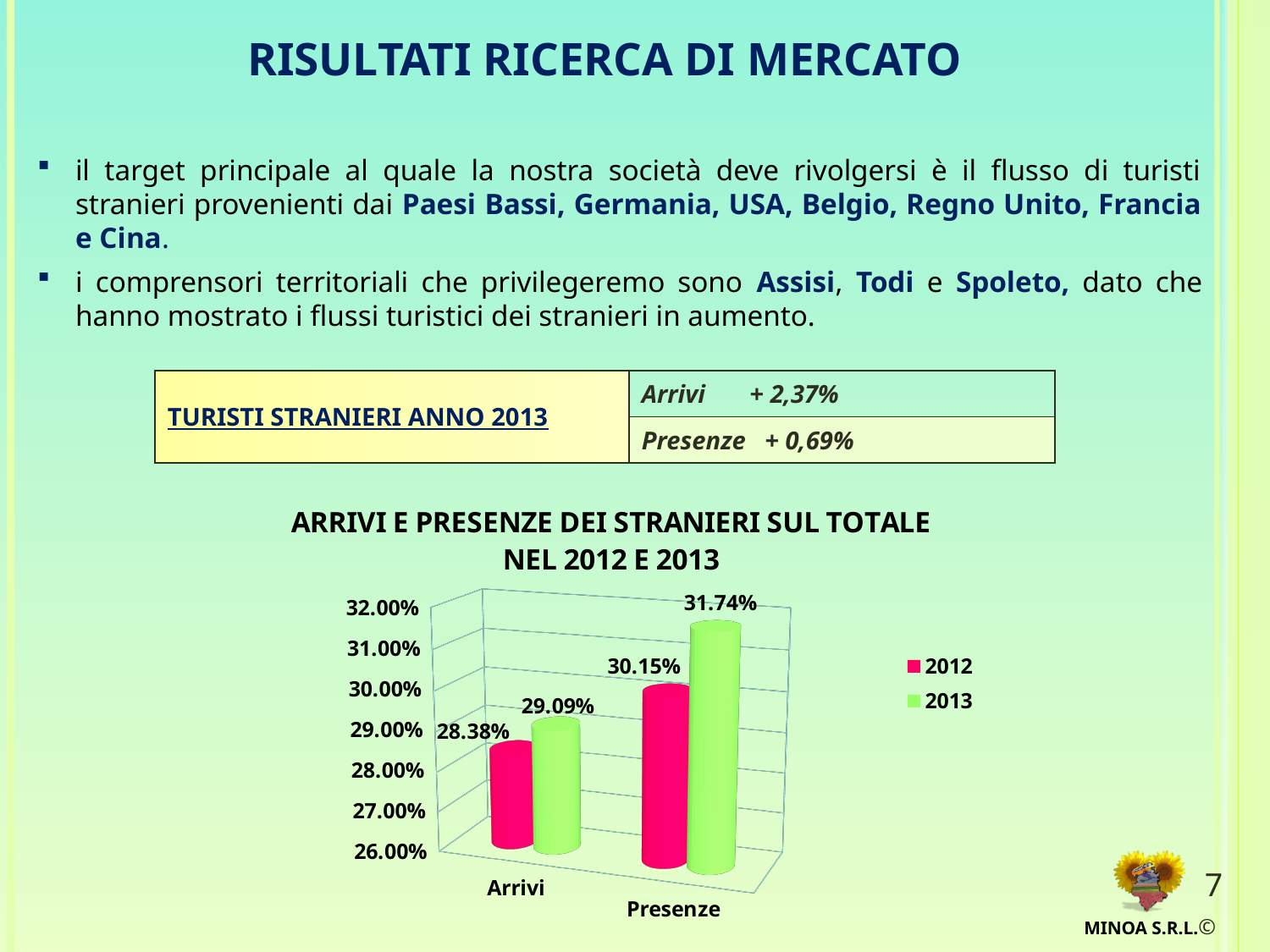
What is the value for Arrivi in 2012? 28.38% How many series does the legend list? 2 What is the value for Presenze in 2012? 30.15% What kind of chart is shown on the slide? Bar chart What is the value for Arrivi in 2013? 29.09% Which bar has the lowest value in the chart? Arrivi 2012 Which is larger, Arrivi in 2013 or Presenze in 2012? Presenze in 2012 What is the difference between the 2013 and 2012 values for Presenze? 1.59% Which bar has the highest value in the chart? Presenze 2013 What is the title of the chart? ARRIVI E PRESENZE DEI STRANIERI SUL TOTALE NEL 2012 E 2013 What is the difference between the 2013 and 2012 values for Arrivi? 0.71% What is the value for Presenze in 2013? 31.74%